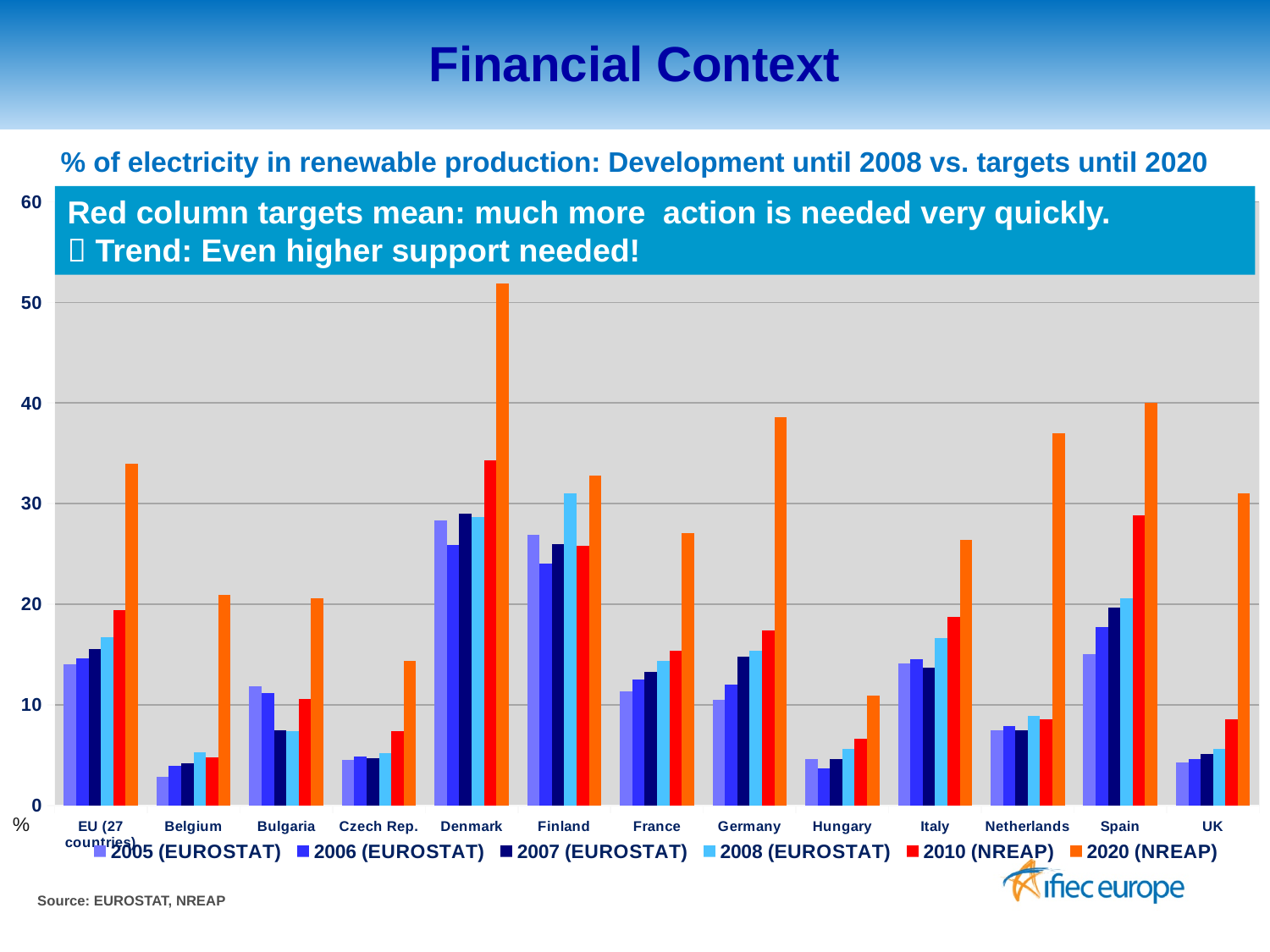
Is the 2020 (NREAP) value for Germany greater or less than 30? greater Which is larger: the 2020 (NREAP) value for the Netherlands or for Italy? Netherlands Is the 2010 (NREAP) value for Belgium greater or less than 10? less How many countries or regions are shown along the x axis of the chart? 13 Which country has the lowest 2020 (NREAP) target in the chart? Hungary Which country has the highest 2020 (NREAP) target in the chart? Denmark What kind of chart is shown on the slide? Bar chart Which is larger: the 2008 (EUROSTAT) value for Finland or for France? Finland Which series in the legend is shown in orange? 2020 (NREAP) How many series does the chart's legend list? 6 Is the 2020 (NREAP) value for Denmark greater or less than 50? greater Which country has the highest 2010 (NREAP) value in the chart? Denmark